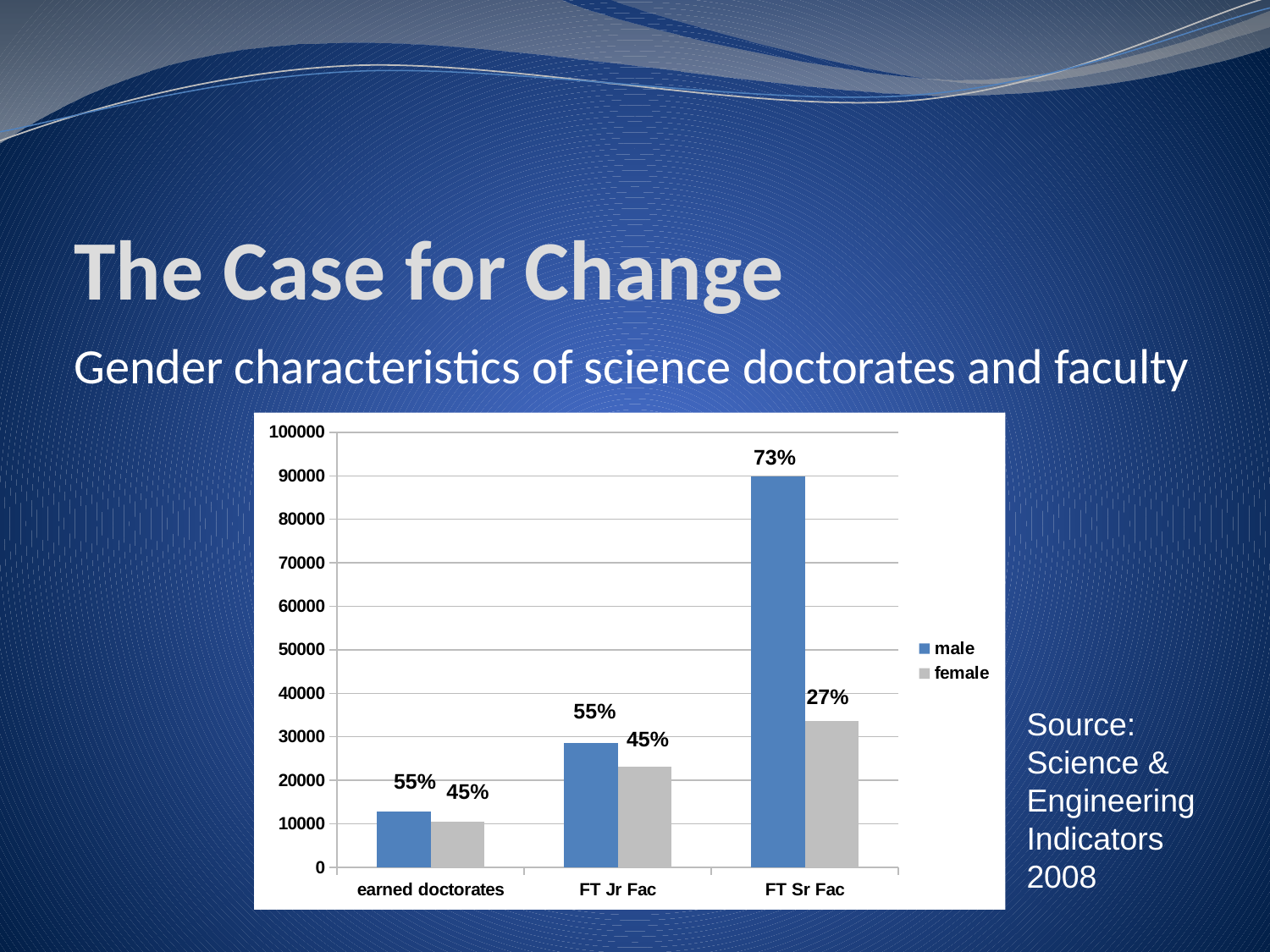
Which category has the tallest male bar? FT Sr Fac Is the male bar for FT Jr Fac greater or less than 30000? less How many series does the chart's legend list? 2 What percentage label is shown on the female bar for FT Jr Fac? 45% What percentage label is shown on the male bar for FT Sr Fac? 73% What percentage label is shown on the female bar for FT Sr Fac? 27% Which series is shown in blue in the chart's legend? male How many categories are shown on the x axis of the chart? 3 What kind of chart is shown on the slide? bar chart What percentage label is shown on the male bar for earned doctorates? 55% Is the male bar for FT Sr Fac greater or less than 80000? greater Which category has the shortest female bar? earned doctorates